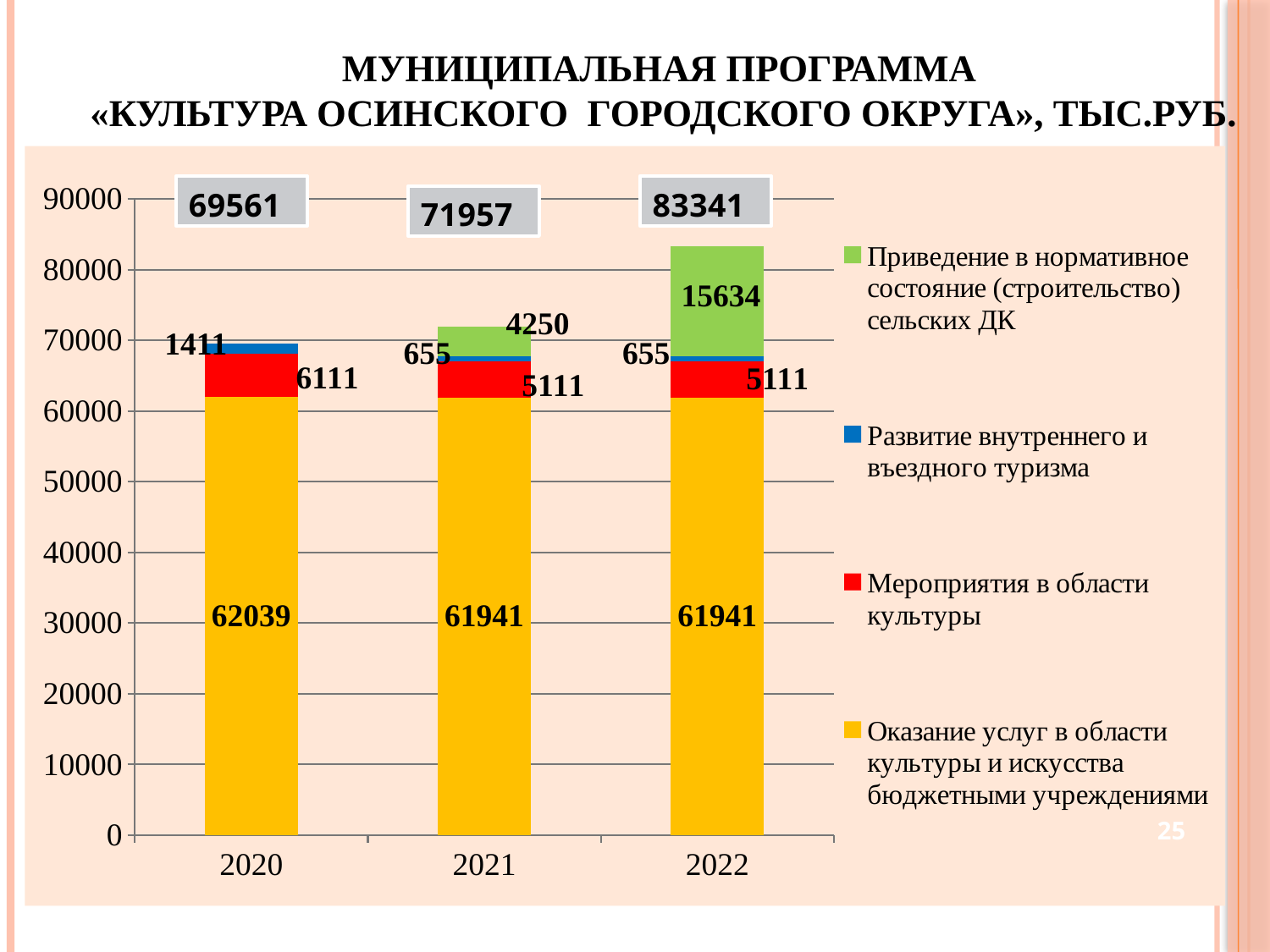
What is the value for 'Мероприятия в области культуры' in 2021? 5111 What is the total value of the stacked bar for 2022? 83341 Which year has the lowest total value? 2020 How many years are shown on the x axis of the chart? 3 What is the value for 'Приведение в нормативное состояние (строительство) сельских ДК' in 2022? 15634 Which year has the highest total value? 2022 What kind of chart is shown on the slide? stacked bar chart What is the difference between the total for 2022 and the total for 2021? 11384 What is the value for 'Развитие внутреннего и въездного туризма' in 2020? 1411 How many series does the legend list? 4 Do the total values rise or fall from 2020 to 2022? rise What is the value for 'Оказание услуг в области культуры и искусства бюджетными учреждениями' in 2020? 62039